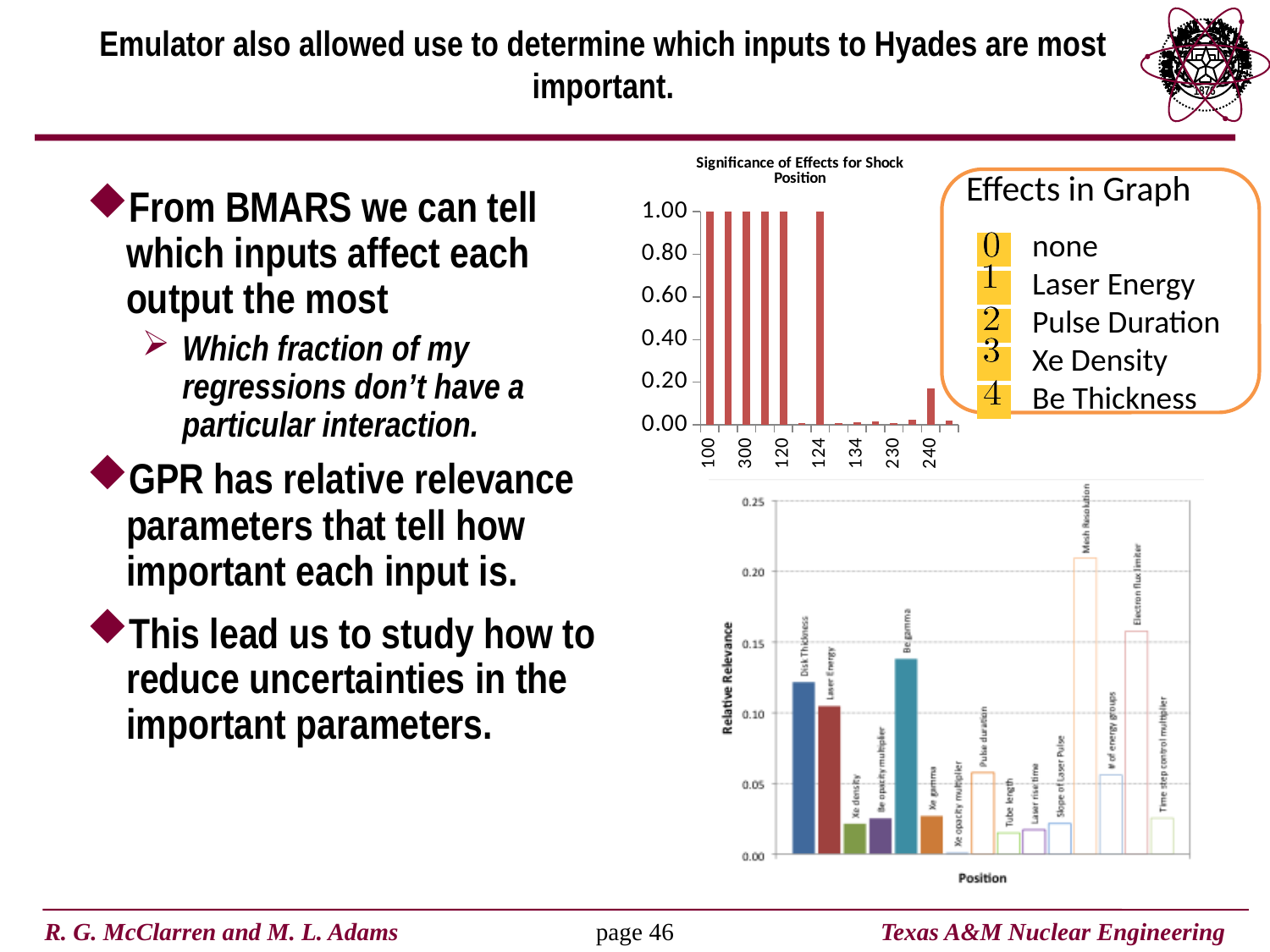
In the bottom chart (Relative Relevance vs Position), which is larger, the value for Be gamma or the value for Laser Energy? Be gamma In the top chart 'Significance of Effects for Shock Position', is the value for 240 greater or less than 0.40? less In the bottom chart, what is the label of the y axis? Relative Relevance In the bottom chart (Relative Relevance vs Position), is the value for Disk Thickness greater or less than 0.10? greater In the top chart 'Significance of Effects for Shock Position', what is the value for category 100? 1.00 In the 'Effects in Graph' box next to the top chart, which effect is listed for code 3? Xe Density In the top chart 'Significance of Effects for Shock Position', what is the value for category 124? 1.00 In the top chart 'Significance of Effects for Shock Position', which is larger, the value for 100 or the value for 134? 100 What kind of chart is the top chart titled 'Significance of Effects for Shock Position'? bar chart In the bottom chart (Relative Relevance vs Position), which input has the highest relative relevance? Mesh Resolution In the bottom chart (Relative Relevance vs Position), is the value for Mesh Resolution greater or less than 0.20? greater